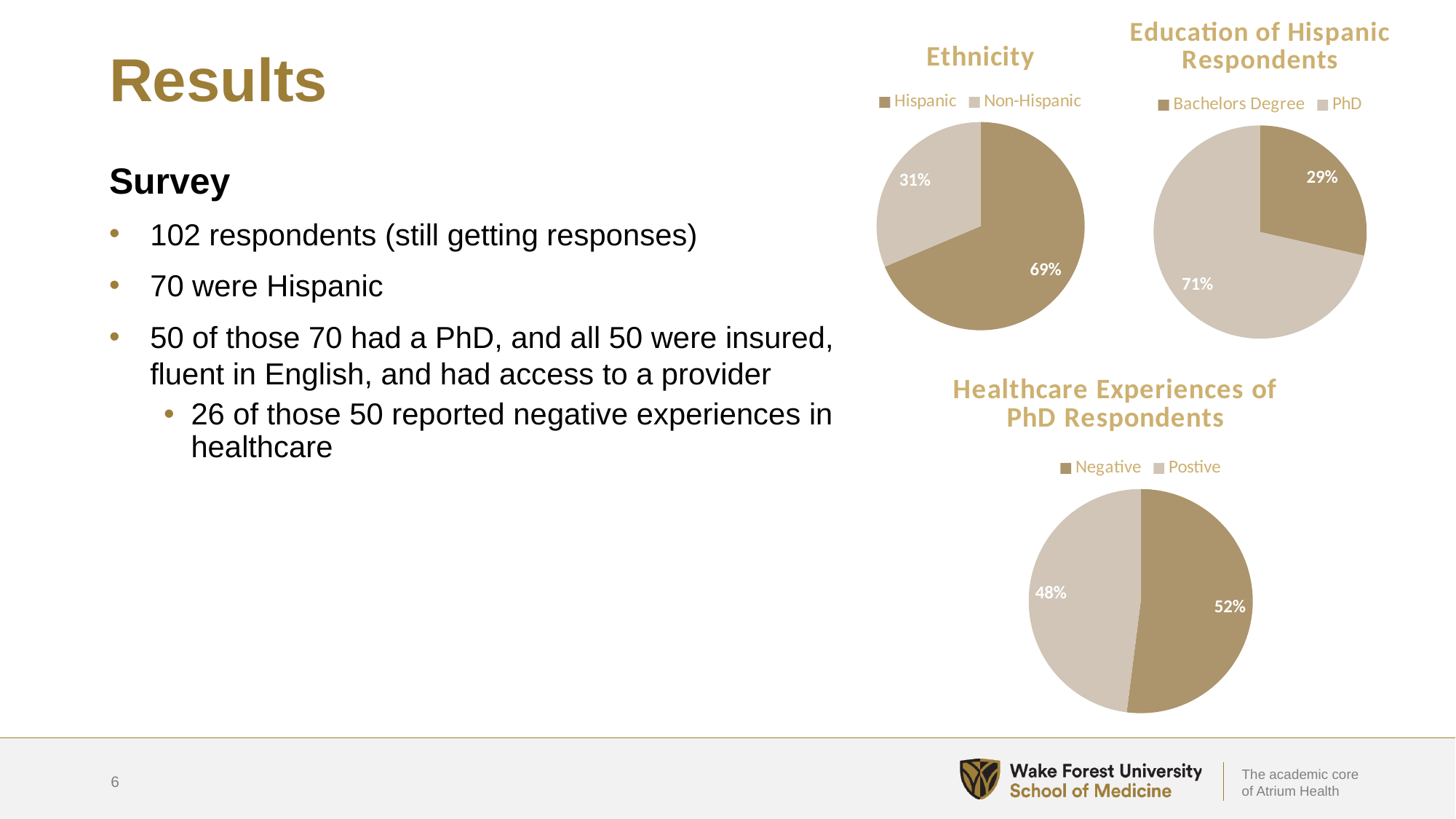
In the Ethnicity chart, what share of respondents are Hispanic? 69% In the Healthcare Experiences of PhD Respondents chart, what share reported negative experiences? 52% How many categories does the legend of the Healthcare Experiences of PhD Respondents chart list? 2 In the Education of Hispanic Respondents chart, which category has the smallest slice? Bachelors Degree In the Education of Hispanic Respondents chart, what is the difference in percentage points between the PhD and Bachelors Degree slices? 42 In the Education of Hispanic Respondents chart, what share have a Bachelors Degree? 29% In the Ethnicity chart, which category has the largest slice? Hispanic In the Education of Hispanic Respondents chart, what share have a PhD? 71% In the Ethnicity chart, what is the difference in percentage points between the Hispanic and Non-Hispanic slices? 38 What kind of chart is the Healthcare Experiences of PhD Respondents chart? Pie chart In the Ethnicity chart, what share of respondents are Non-Hispanic? 31% In the Healthcare Experiences of PhD Respondents chart, what share reported positive experiences? 48%